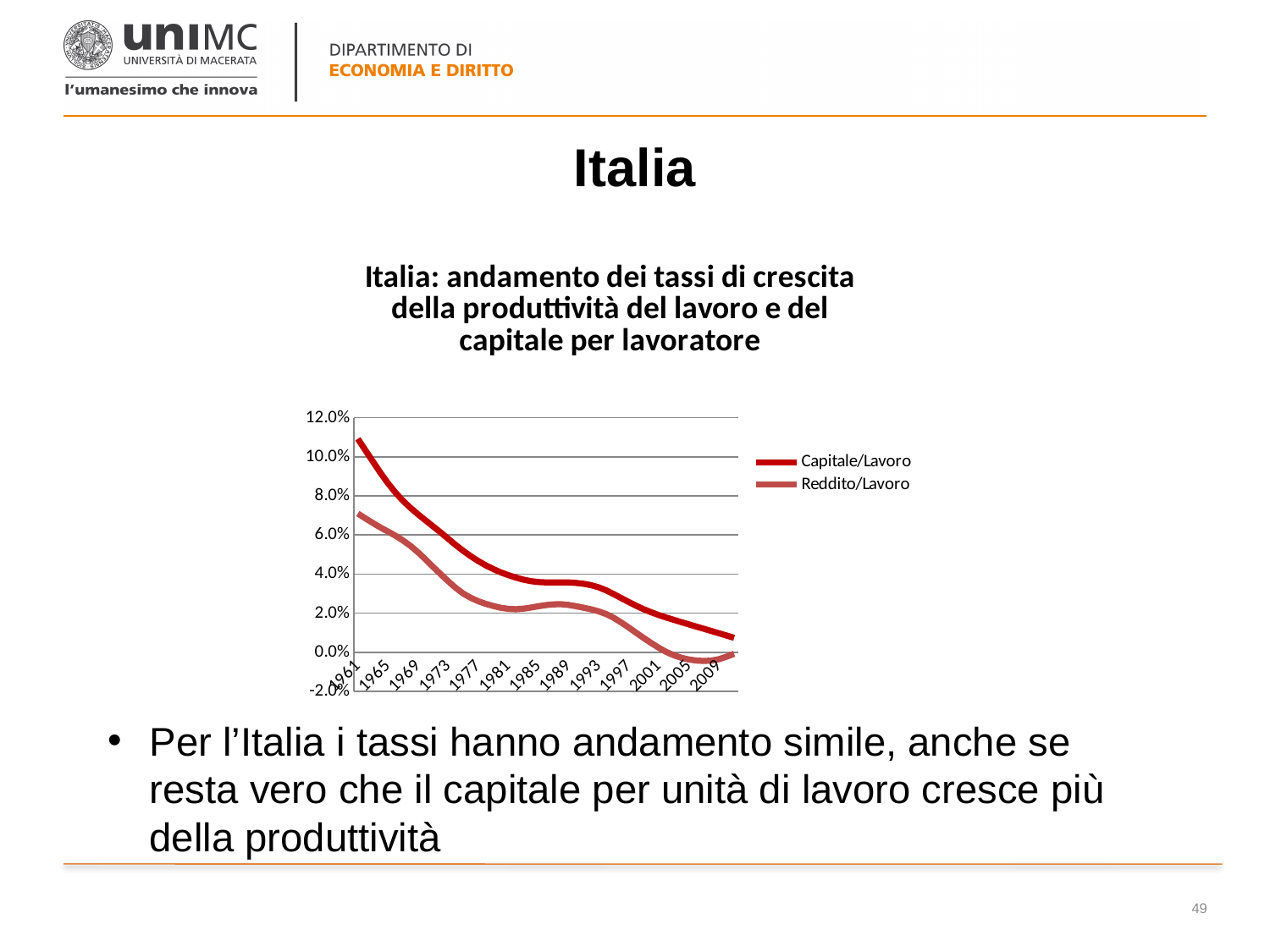
In 1961, which series has the higher value, Capitale/Lavoro or Reddito/Lavoro? Capitale/Lavoro Is the value for Reddito/Lavoro in 1961 greater or less than 8.0%? less How many series does the legend list? 2 Do the values of the Reddito/Lavoro series rise or fall from 1961 to 1981? fall What are the two series named in the legend? Capitale/Lavoro and Reddito/Lavoro How many year labels are shown on the x axis? 13 Is the value for Capitale/Lavoro in 1961 greater or less than 10.0%? greater Is the value for Capitale/Lavoro in 2009 greater or less than 2.0%? less What kind of chart is shown on the slide? line chart Do the values of the Capitale/Lavoro series rise or fall from 1961 to 2009? fall What is the title of the chart? Italia: andamento dei tassi di crescita della produttività del lavoro e del capitale per lavoratore